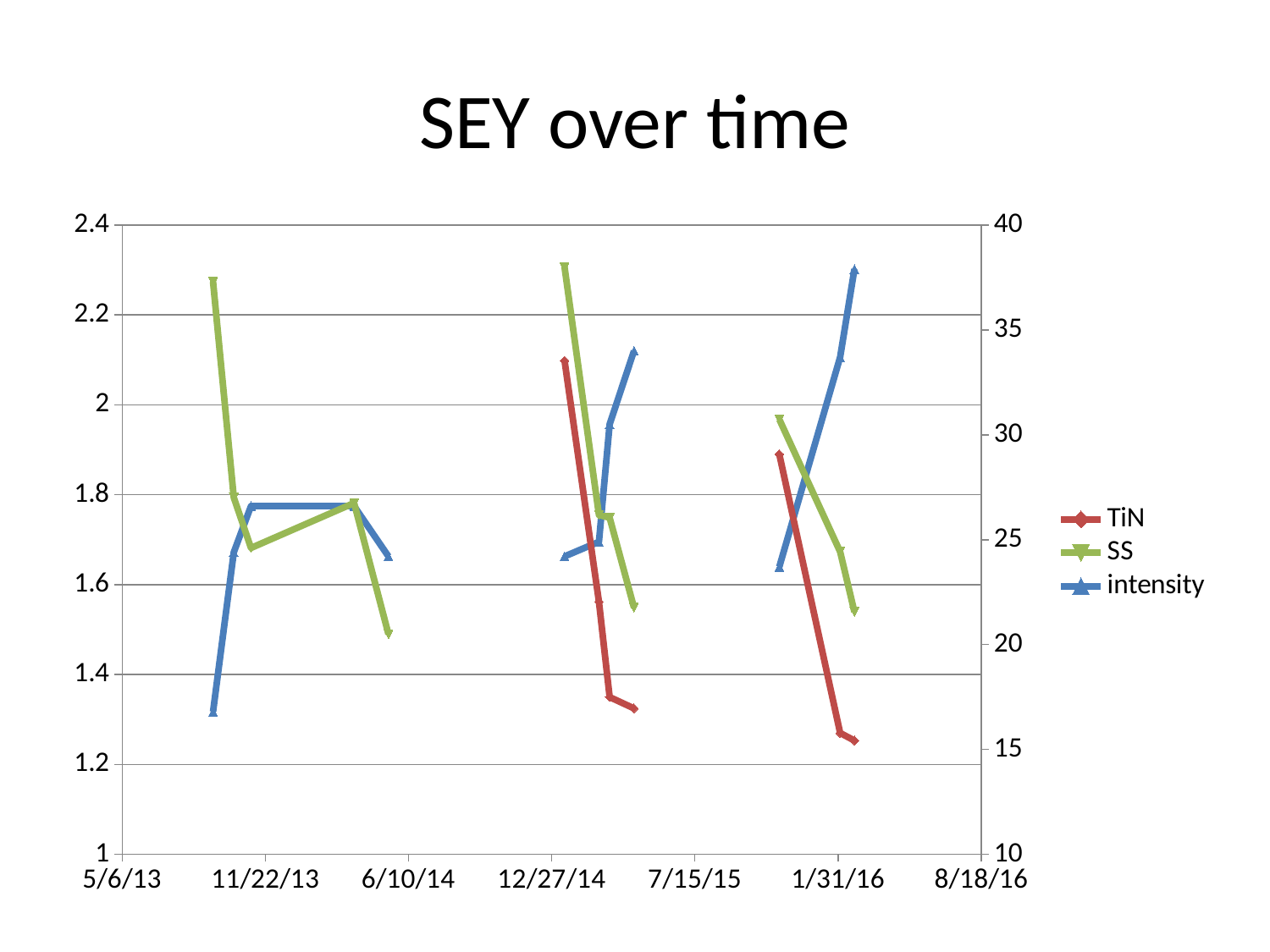
How many series does the legend list? 3 Which series reaches a higher value on the left axis, SS or TiN? SS Is the highest value of the intensity series greater or less than 35 on the right axis? greater Is the first plotted value of the intensity series greater or less than 20 on the right axis? less Is the highest value of the SS series greater or less than 2.2 on the left axis? greater Which series are listed in the legend? TiN, SS, intensity What kind of chart is shown on the slide? line chart Does the intensity series rise or fall over time in the segment plotted around 1/31/16? rise What is the title of the chart? SEY over time What is the maximum value shown on the right-hand axis? 40 Does the TiN series rise or fall over time within each of its plotted segments? fall